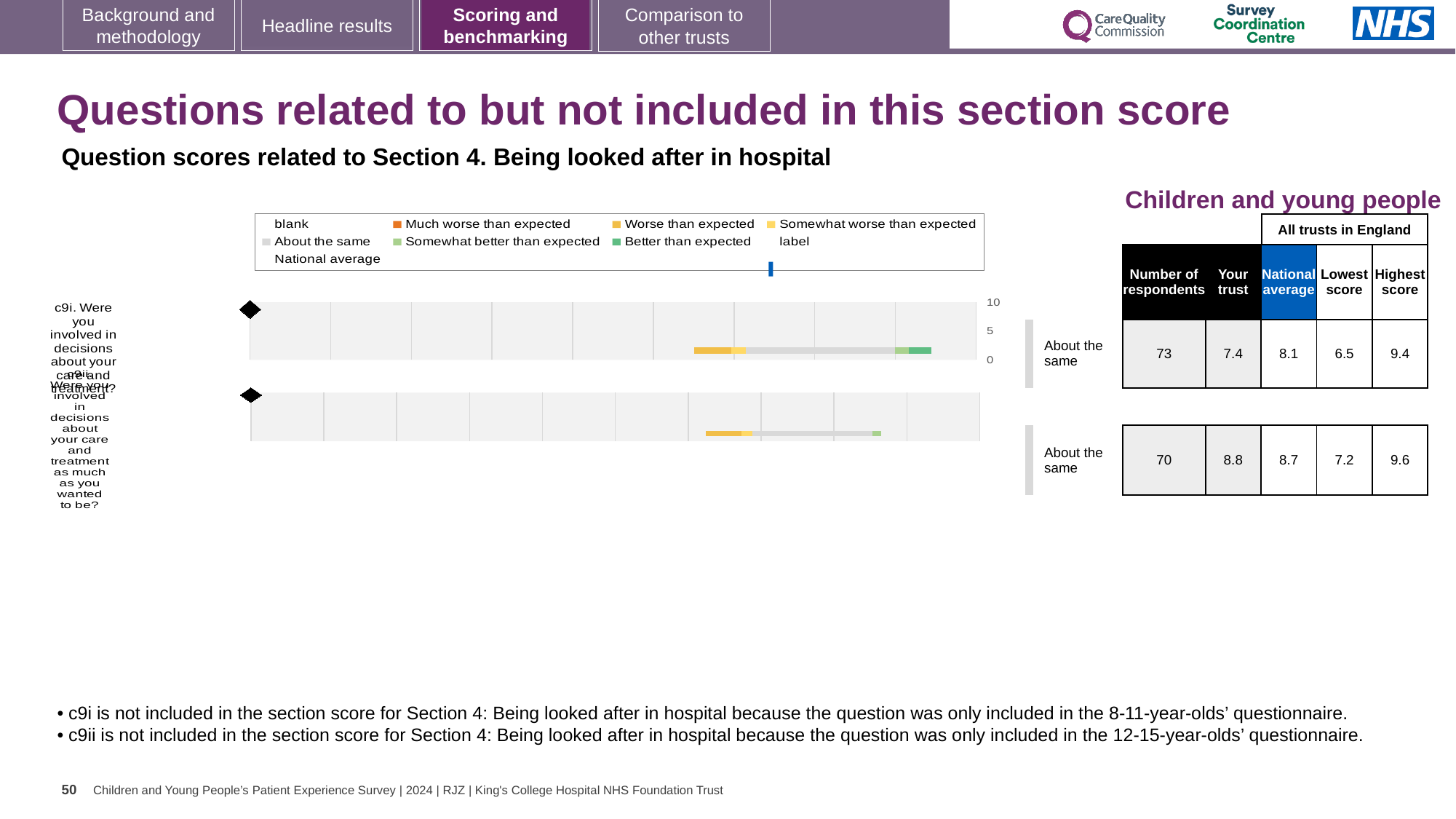
How is the trust's result for c9ii categorised relative to expectations? About the same How many respondents answered c9i? 73 What is the national average score for c9i? 8.1 How many questions (bars) are plotted on the chart? 2 Which question has the higher 'Your trust' score, c9i or c9ii? c9ii What is the highest score among all trusts in England for c9ii? 9.6 What is the 'Your trust' score for c9i (Were you involved in decisions about your care and treatment?)? 7.4 What is the lowest score among all trusts in England for c9i? 6.5 What is the 'Your trust' score for c9ii (Were you involved in decisions about your care and treatment as much as you wanted to be?)? 8.8 What kind of chart is used to show the question scores for c9i and c9ii? bar chart What is the national average score for c9ii? 8.7 What is the difference between the highest and lowest scores for c9i? 2.9